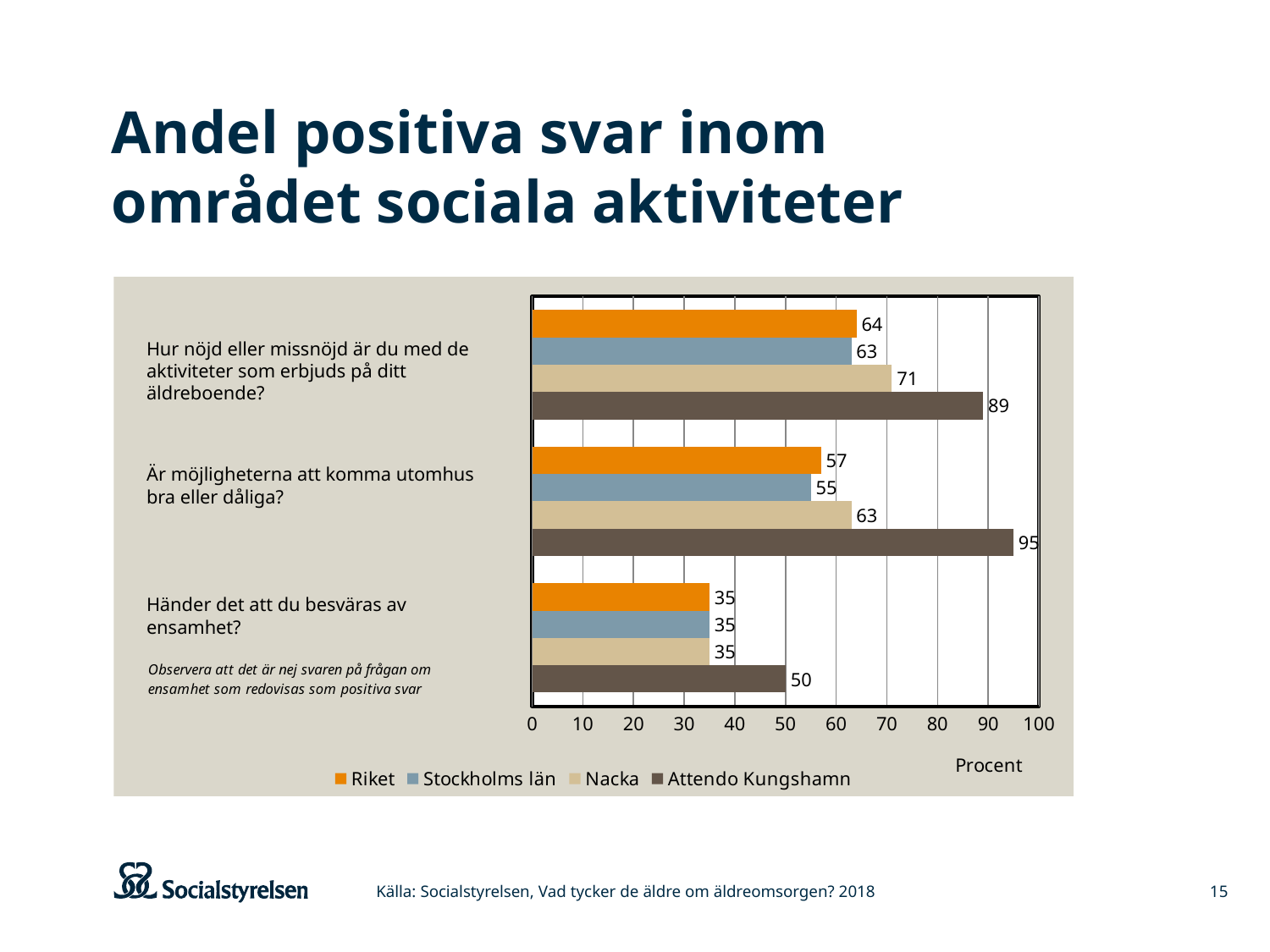
What is the difference between Attendo Kungshamn and Riket on the question "Är möjligheterna att komma utomhus bra eller dåliga?"? 38 Which series has the lowest value on the question "Är möjligheterna att komma utomhus bra eller dåliga?"? Stockholms län What is the difference between Attendo Kungshamn and Nacka on the question "Händer det att du besväras av ensamhet?"? 15 What is the label of the horizontal axis? Procent How many questions (categories) are shown on the chart? 3 What is the value for Riket on the question "Händer det att du besväras av ensamhet?"? 35 Which series has the highest value on the question "Hur nöjd eller missnöjd är du med de aktiviteter som erbjuds på ditt äldreboende?"? Attendo Kungshamn What is the value for Attendo Kungshamn on the question "Är möjligheterna att komma utomhus bra eller dåliga?"? 95 What is the value for Nacka on the question "Hur nöjd eller missnöjd är du med de aktiviteter som erbjuds på ditt äldreboende?"? 71 What kind of chart is shown on the slide? Bar chart How many series does the legend list? 4 Which is larger on the question "Hur nöjd eller missnöjd är du med de aktiviteter som erbjuds på ditt äldreboende?": Riket or Nacka? Nacka